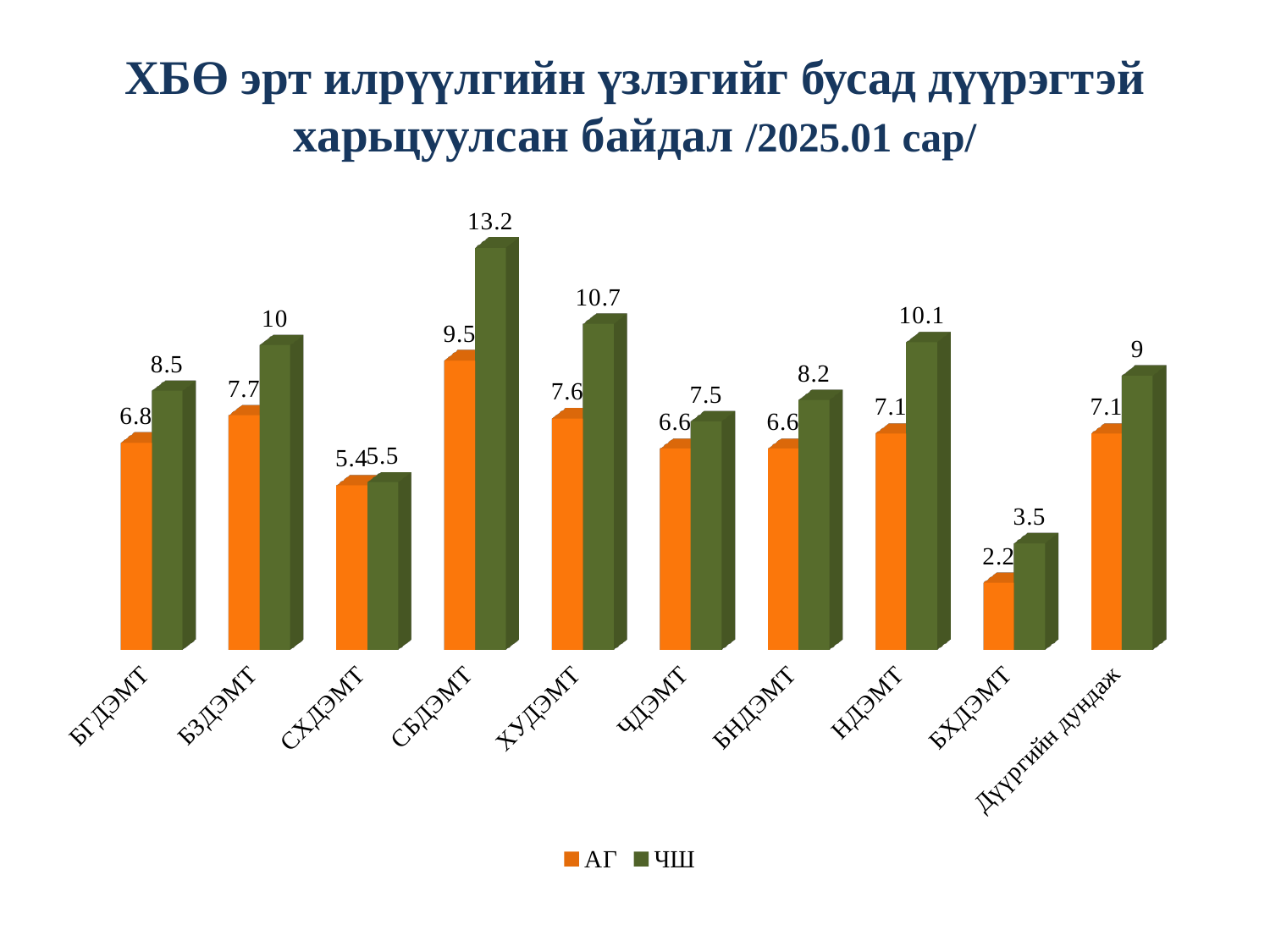
What is the difference between the ЧШ values for ХУДЭМТ and НДЭМТ? 0.6 What is the ЧШ value for Дүүргийн дундаж? 9 What kind of chart is shown on the slide? Bar chart What is the АГ value for ХУДЭМТ? 7.6 Which category has the lowest АГ value? БХДЭМТ How many categories are shown on the x axis? 10 What is the АГ value for БХДЭМТ? 2.2 What is the ЧШ value for СБДЭМТ? 13.2 How many series does the legend list? 2 Which category has the highest ЧШ value? СБДЭМТ What is the difference between the ЧШ and АГ values for СБДЭМТ? 3.7 Which is larger, the АГ value for БЗДЭМТ or the АГ value for НДЭМТ? БЗДЭМТ